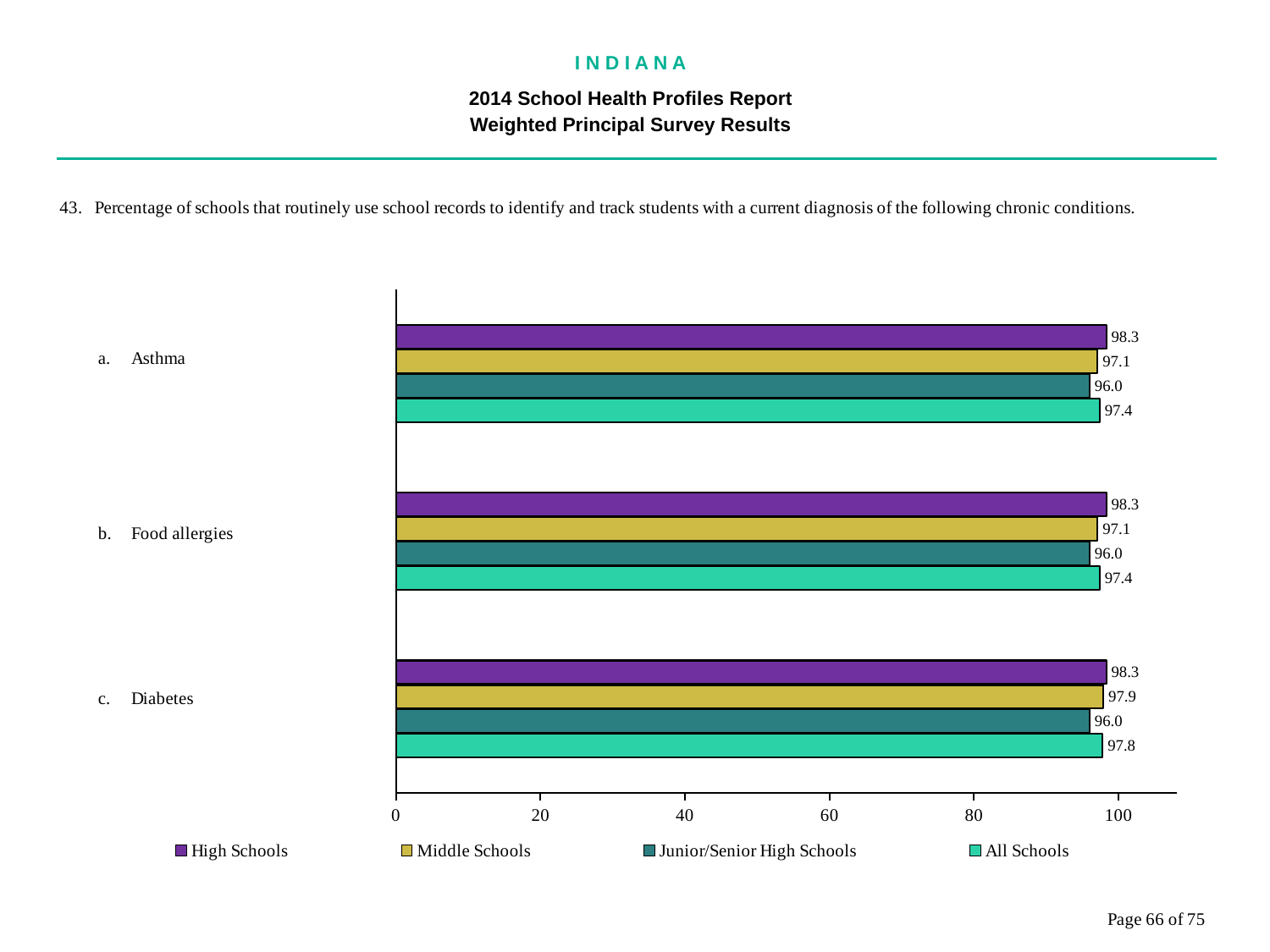
How many series does the legend list? 4 Which school type has the highest value for Diabetes? High Schools What is the value for All Schools for Diabetes? 97.8 What is the difference between the High Schools and Junior/Senior High Schools values for Food allergies? 2.3 How many chronic conditions are shown on the chart? 3 What kind of chart is shown on the slide? Bar chart What is the value for Junior/Senior High Schools for Food allergies? 96.0 Which series is shown in purple in the legend? High Schools What is the value for High Schools for Asthma? 98.3 Which school type has the lowest value for Asthma? Junior/Senior High Schools What is the value for Middle Schools for Diabetes? 97.9 Which is larger: the Middle Schools value for Diabetes or the Middle Schools value for Asthma? Diabetes